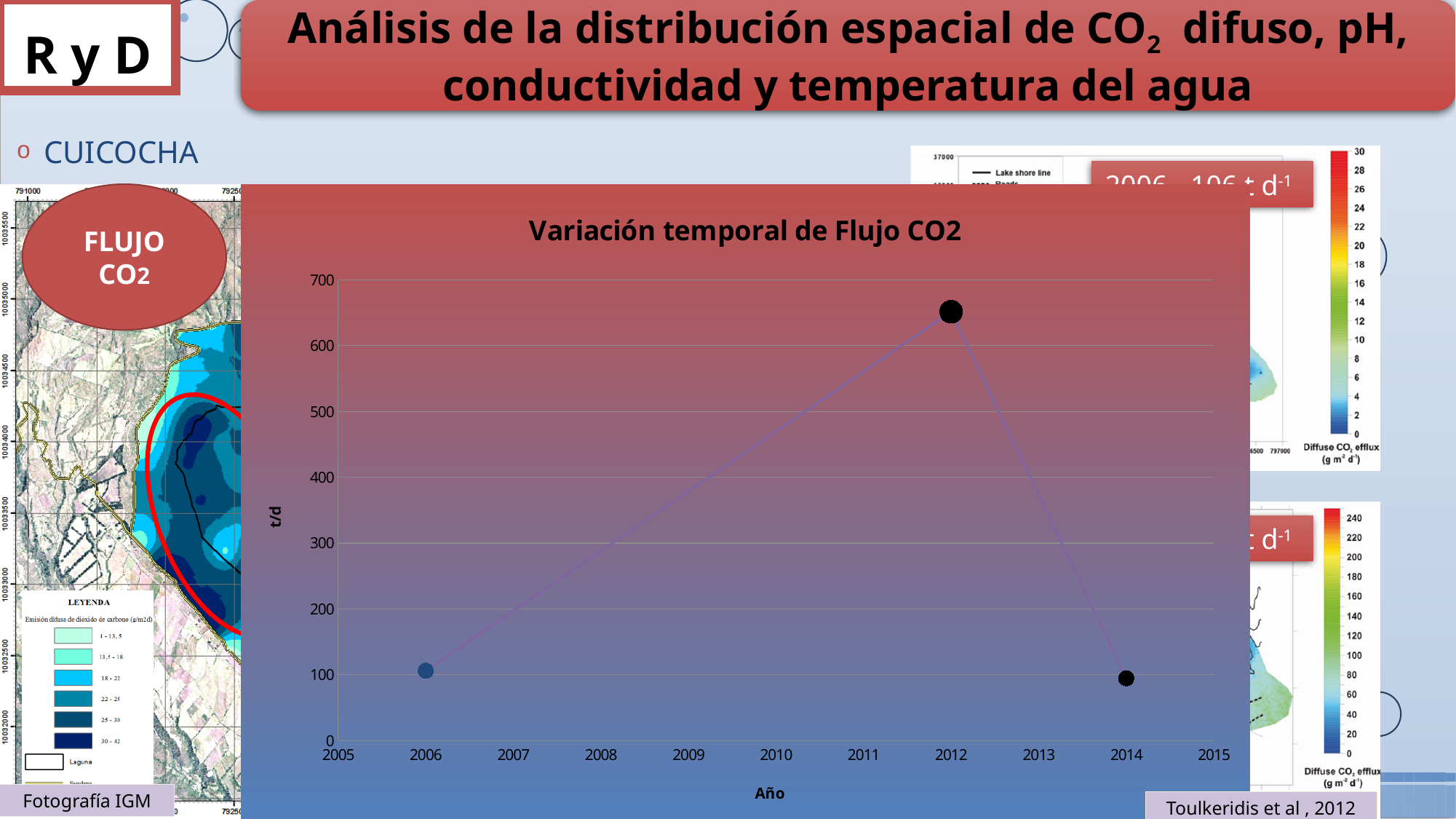
In the 'Variación temporal de Flujo CO2' chart, is the value for 2012 greater or less than 600? greater What kind of chart is 'Variación temporal de Flujo CO2'? line chart In the 'Variación temporal de Flujo CO2' chart, is the value for 2014 greater or less than 200? less What is the label of the vertical axis in the 'Variación temporal de Flujo CO2' chart? t/d In the 'Variación temporal de Flujo CO2' chart, is the value for 2012 greater or less than 700? less In the 'Variación temporal de Flujo CO2' chart, which year has the highest CO2 flux value? 2012 In the 'Variación temporal de Flujo CO2' chart, which is larger, the value for 2012 or the value for 2006? 2012 In the 'Variación temporal de Flujo CO2' chart, does the value rise or fall from 2012 to 2014? fall What is the label of the horizontal axis in the 'Variación temporal de Flujo CO2' chart? Año How many data points are plotted in the 'Variación temporal de Flujo CO2' chart? 3 In the 'Variación temporal de Flujo CO2' chart, does the value rise or fall from 2006 to 2012? rise